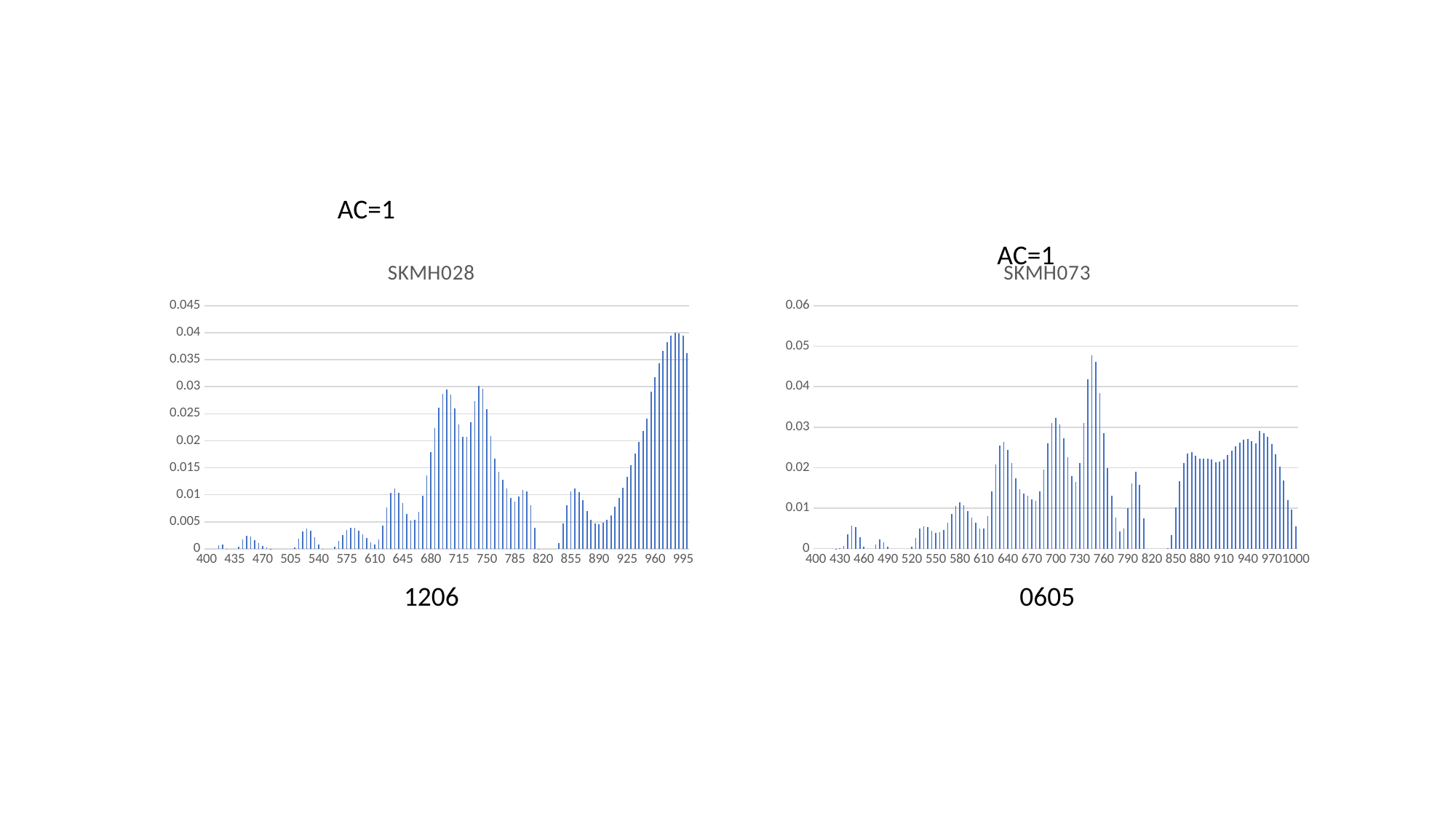
In the SKMH028 chart, is the value at 890 greater or less than 0.01? less In the SKMH028 chart, is the value at 995 greater or less than 0.02? greater In the SKMH028 chart, do the values rise or fall from 925 to 995 along the x axis? rise In the SKMH028 chart, is the value at 400 greater or less than 0.005? less In the SKMH073 chart, do the values rise or fall from 970 to 1000 along the x axis? fall In the SKMH073 chart, what is the highest value shown on the y axis? 0.06 What kind of chart is the SKMH028 chart on the left? bar chart What is the title of the chart on the right? SKMH073 In the SKMH028 chart, what is the highest value shown on the y axis? 0.045